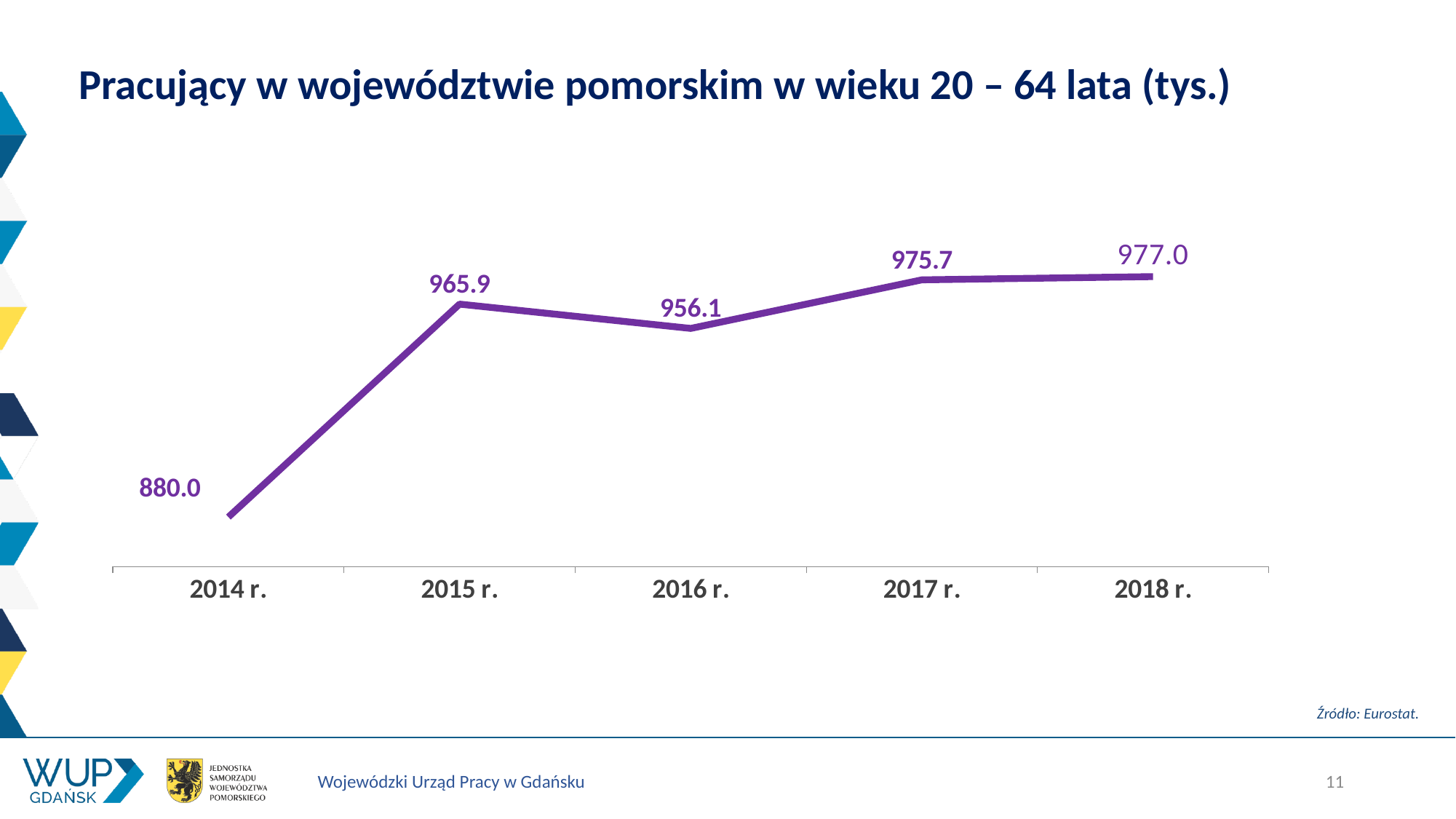
What is the title of the chart? Pracujący w województwie pomorskim w wieku 20 – 64 lata (tys.) What is the value for 2016 r.? 956.1 Do the values generally rise or fall from 2014 r. to 2018 r.? rise What is the difference between the values for 2015 r. and 2014 r.? 85.9 What is the value for 2014 r.? 880.0 Which year has the highest value? 2018 r. How many years are plotted on the chart? 5 What is the difference between the values for 2017 r. and 2016 r.? 19.6 What is the value for 2018 r.? 977.0 What kind of chart is shown on the slide? line chart Which is larger, the value for 2015 r. or the value for 2016 r.? 2015 r. Which year has the lowest value? 2014 r.